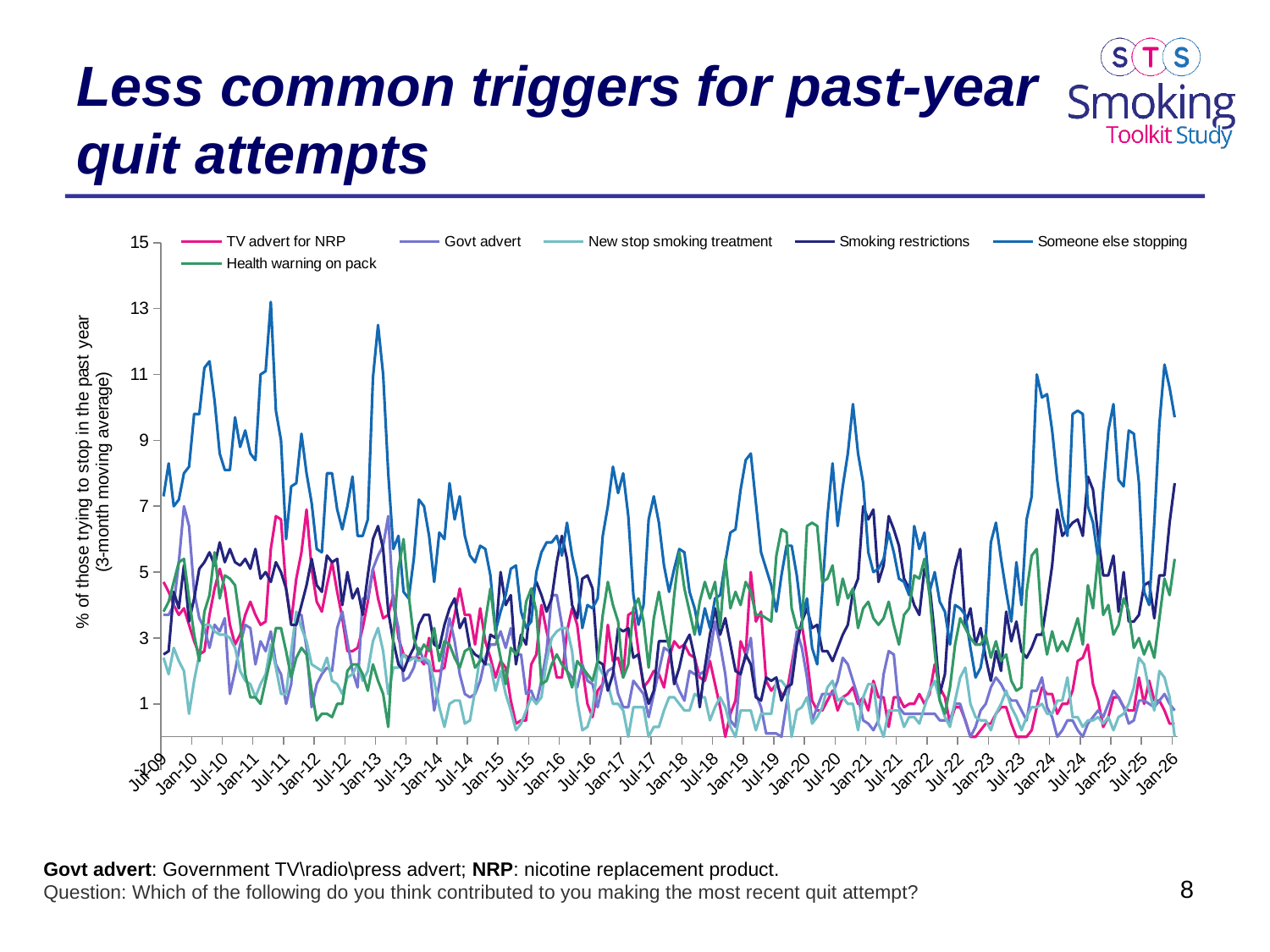
Is the peak value for Someone else stopping greater or less than 11? greater What is the highest tick value shown on the y axis? 15 At Jan-26, which is larger: Someone else stopping or Health warning on pack? Someone else stopping What kind of chart is shown on the slide? line chart Which series has the highest value at Jan-26? Someone else stopping What is the first label on the x axis? Jul-09 Which series reaches the highest values on the chart? Someone else stopping How many series does the legend list? 6 Is the value for Smoking restrictions at Jan-26 greater or less than 5? greater Is the value for Someone else stopping at Jan-26 greater or less than 7? greater